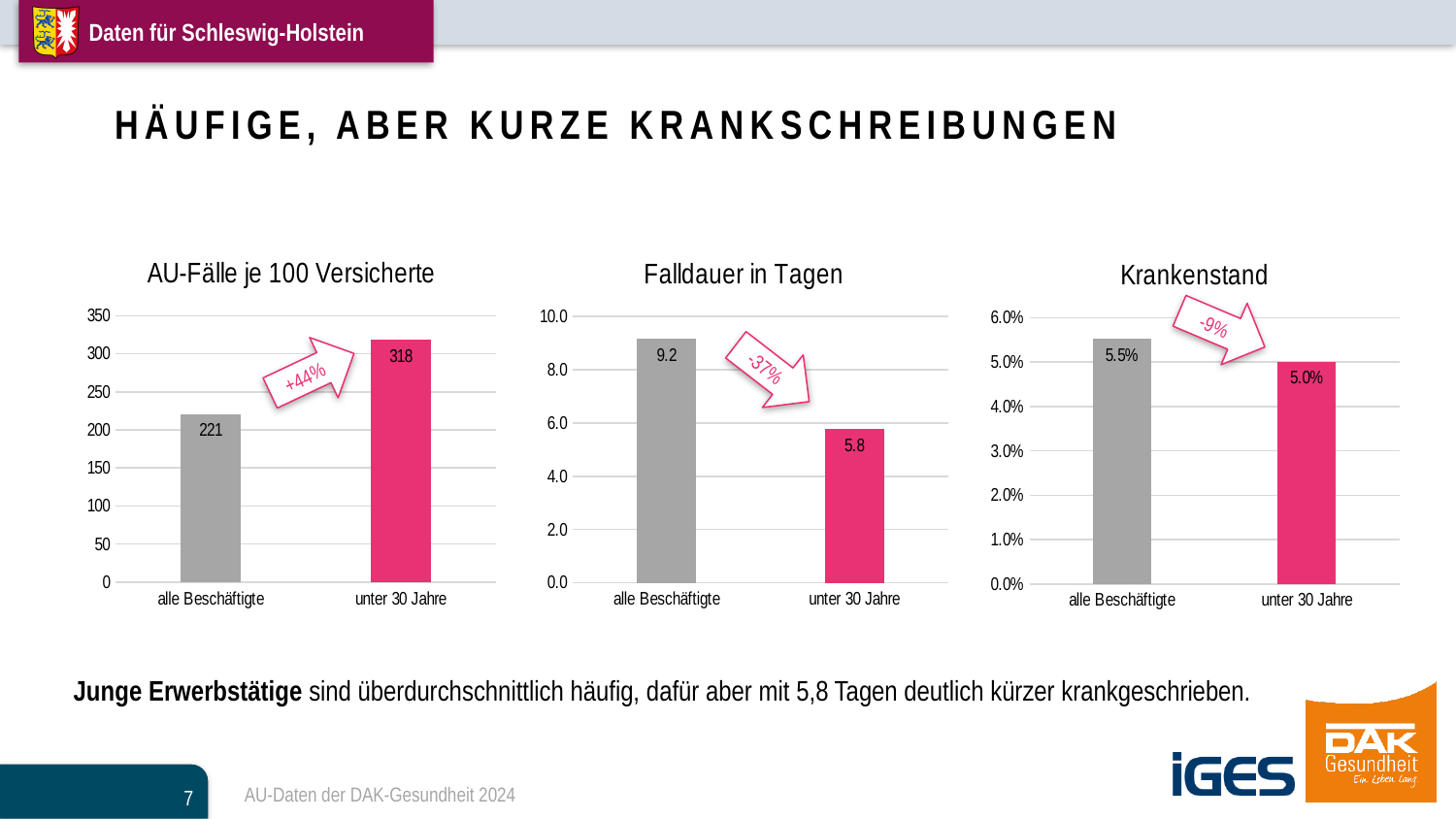
In the chart titled "AU-Fälle je 100 Versicherte", what is the value for "alle Beschäftigte"? 221 In the chart titled "Falldauer in Tagen", what is the value for "unter 30 Jahre"? 5.8 What kind of chart is the chart titled "Falldauer in Tagen"? bar chart How many categories does the chart titled "Krankenstand" show? 2 In the chart titled "Krankenstand", which category has the highest value? alle Beschäftigte In the chart titled "AU-Fälle je 100 Versicherte", what is the difference between the values for "unter 30 Jahre" and "alle Beschäftigte"? 97 In the chart titled "Falldauer in Tagen", which category has the lower value? unter 30 Jahre In the chart titled "AU-Fälle je 100 Versicherte", is the value for "alle Beschäftigte" greater or less than 250? less In the chart titled "AU-Fälle je 100 Versicherte", what is the value for "unter 30 Jahre"? 318 In the chart titled "Falldauer in Tagen", what is the value for "alle Beschäftigte"? 9.2 In the chart titled "Krankenstand", what is the value for "unter 30 Jahre"? 5.0% In the chart titled "Falldauer in Tagen", what is the difference between the values for "alle Beschäftigte" and "unter 30 Jahre"? 3.4